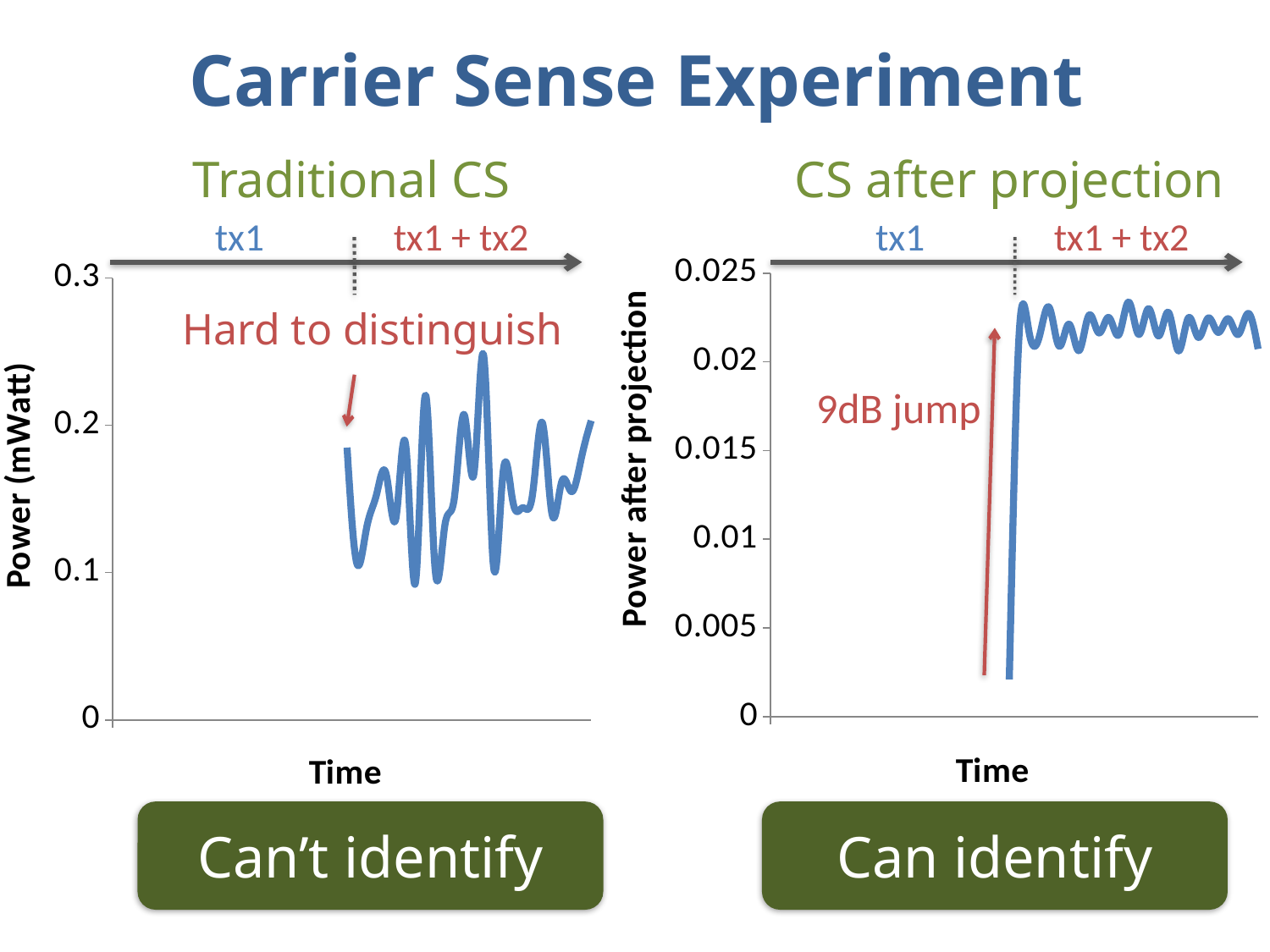
On the 'CS after projection' chart, which region has the higher plotted values, 'tx1' or 'tx1 + tx2'? tx1 + tx2 On the 'Traditional CS' chart, is the lowest plotted value greater or less than 0.2? less On the 'Traditional CS' chart, is the highest plotted value greater or less than 0.3? less What kind of chart is the 'Traditional CS' chart on the left? line chart What kind of chart is the 'CS after projection' chart on the right? line chart On the 'CS after projection' chart, are the values in the 'tx1 + tx2' region greater or less than 0.025? less What is the highest tick value shown on the y axis of the 'CS after projection' chart? 0.025 On the 'CS after projection' chart, what is the label of the y axis? Power after projection On the 'Traditional CS' chart, what is the label of the y axis? Power (mWatt) On the 'CS after projection' chart, does the plotted value rise or fall when moving from the 'tx1' region into the 'tx1 + tx2' region? rise